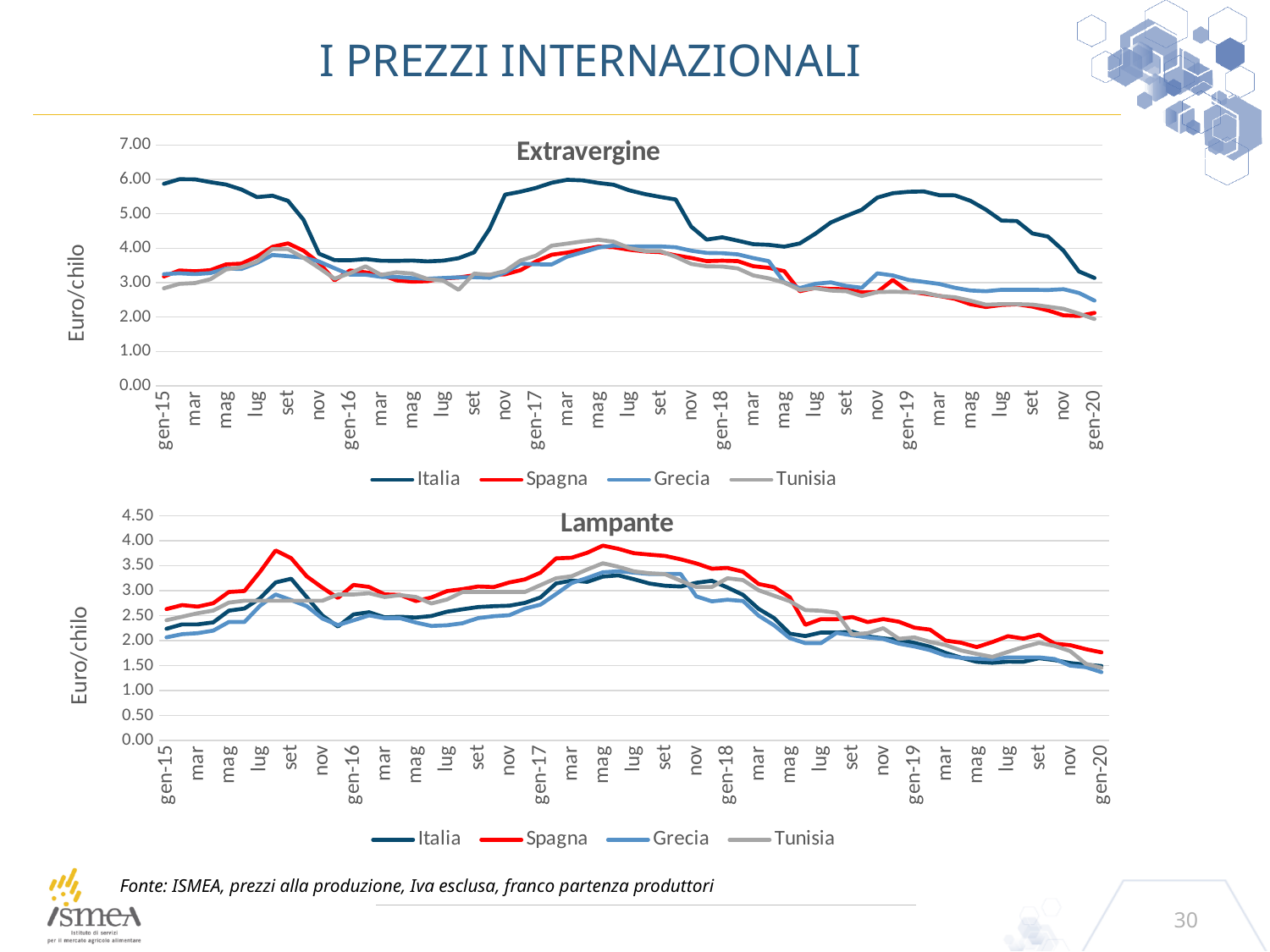
In the Lampante chart, which is larger at gen-20: the value for Spagna or the value for Italia? Spagna In the Lampante chart, is the value for Spagna at set-15 greater or less than 3.50? greater In the Lampante chart, is the value for Italia at gen-20 greater or less than 2.00? less What is the y-axis label of the Extravergine chart? Euro/chilo In the Lampante chart, which series has the highest value at set-15? Spagna What kind of chart is the Extravergine chart? line chart In the Lampante chart, does the Italia series rise or fall from gen-18 to gen-20? fall In the Extravergine chart, is the value for Spagna at gen-20 greater or less than 3.00? less How many series does the legend of the Lampante chart list? 4 In the Extravergine chart, which is larger at gen-15: the value for Italia or the value for Tunisia? Italia In the Extravergine chart, which series has the highest value at gen-15? Italia